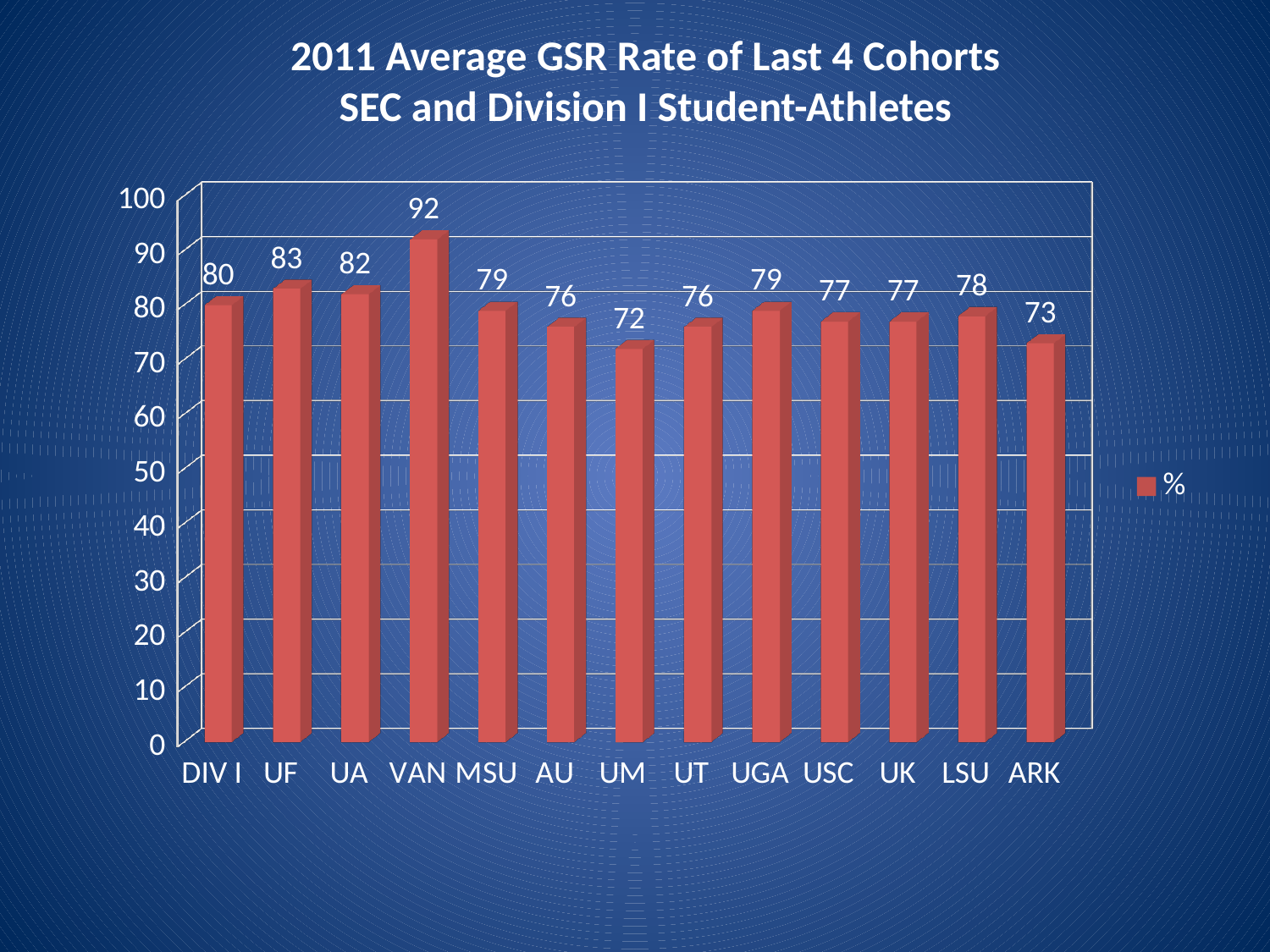
Which category has the highest value? VAN Which category has the lowest value? UM What is the difference between the values for UF and ARK? 10 Which is larger, the value for UA or the value for MSU? UA How many series does the legend list? 1 What is the value for DIV I? 80 What is the value for LSU? 78 How many categories are shown on the x axis? 13 What is the difference between the values for VAN and UM? 20 What kind of chart is shown on the slide? bar chart What is the title of the chart? 2011 Average GSR Rate of Last 4 Cohorts SEC and Division I Student-Athletes What is the value for VAN? 92